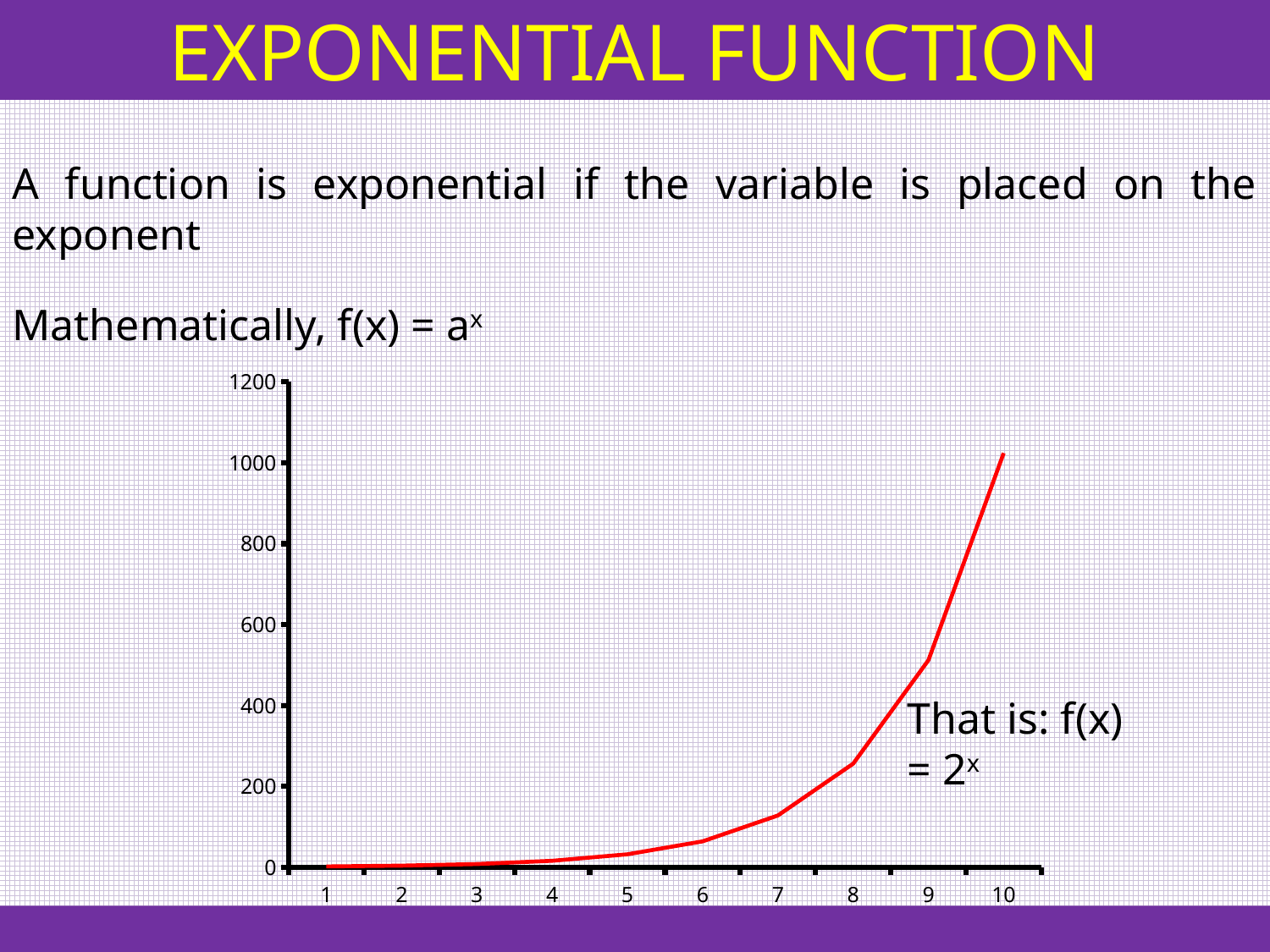
At which x value is the plotted value lowest? 1 Is the value at x = 10 greater or less than 800? greater At which x value is the plotted value highest? 10 Is the value at x = 7 greater or less than 200? less What colour is the plotted line? red How many x-axis points are plotted on the chart? 10 Which has the larger plotted value, x = 8 or x = 9? x = 9 What function does the annotation next to the curve say is plotted? f(x) = 2^x Is the value at x = 9 greater or less than 600? less Do the plotted values rise or fall as x increases from 1 to 10? rise What kind of chart is shown on the slide? line chart